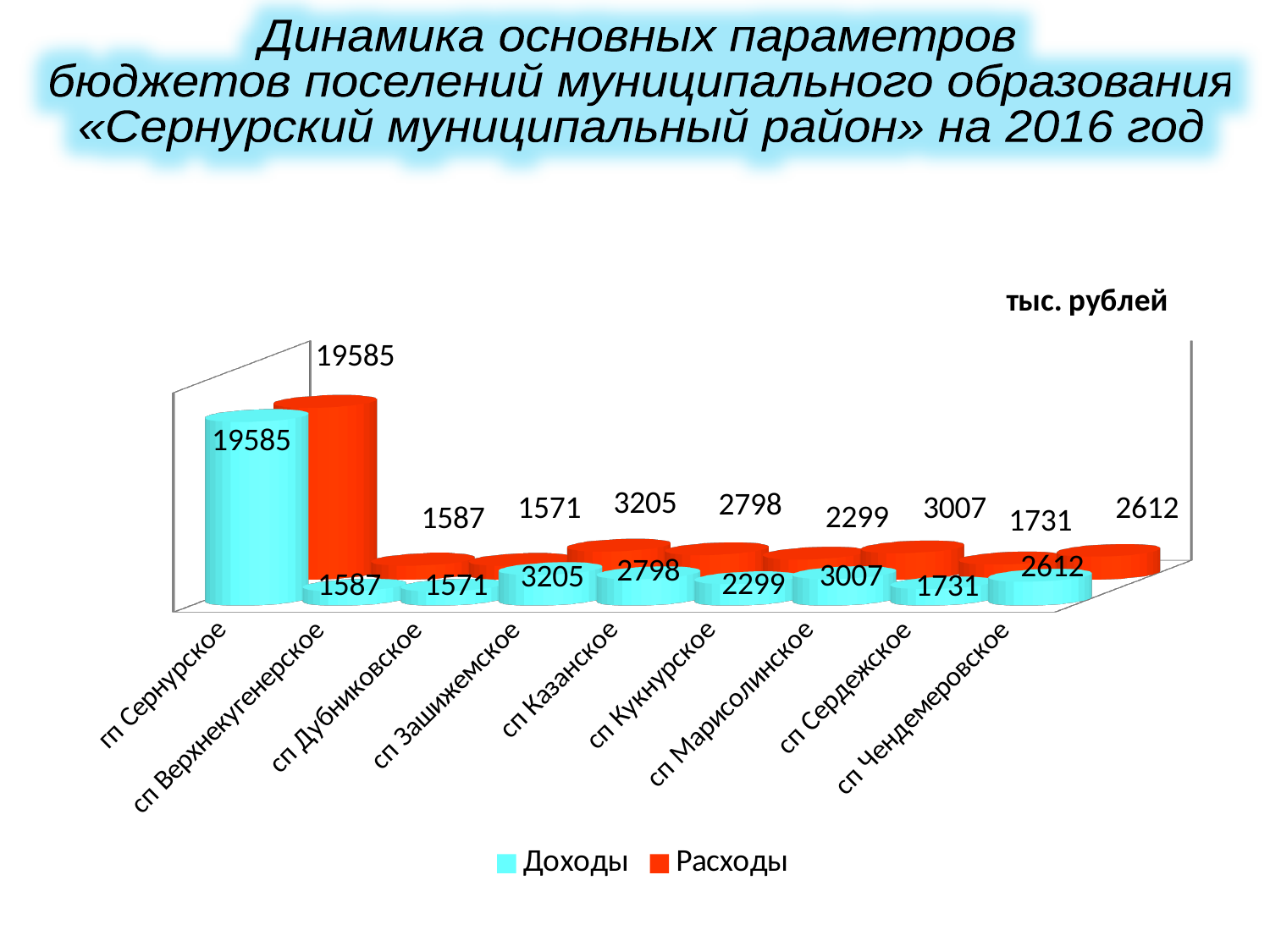
What unit is indicated above the chart? тыс. рублей What is the value of Доходы for сп Марисолинское? 3007 How many series does the legend list? 2 What is the difference between the Доходы values for сп Зашижемское and сп Сердежское? 1474 What is the value of Расходы for сп Чендемеровское? 2612 How many settlements (categories) are shown on the x axis? 9 Which settlement has the lowest Расходы value? сп Дубниковское What kind of chart is shown on the slide? bar chart Which is larger, the Расходы value for сп Кукнурское or for сп Марисолинское? сп Марисолинское What is the value of Расходы for сп Казанское? 2798 What is the value of Доходы for гп Сернурское? 19585 Which settlement has the highest Доходы value? гп Сернурское